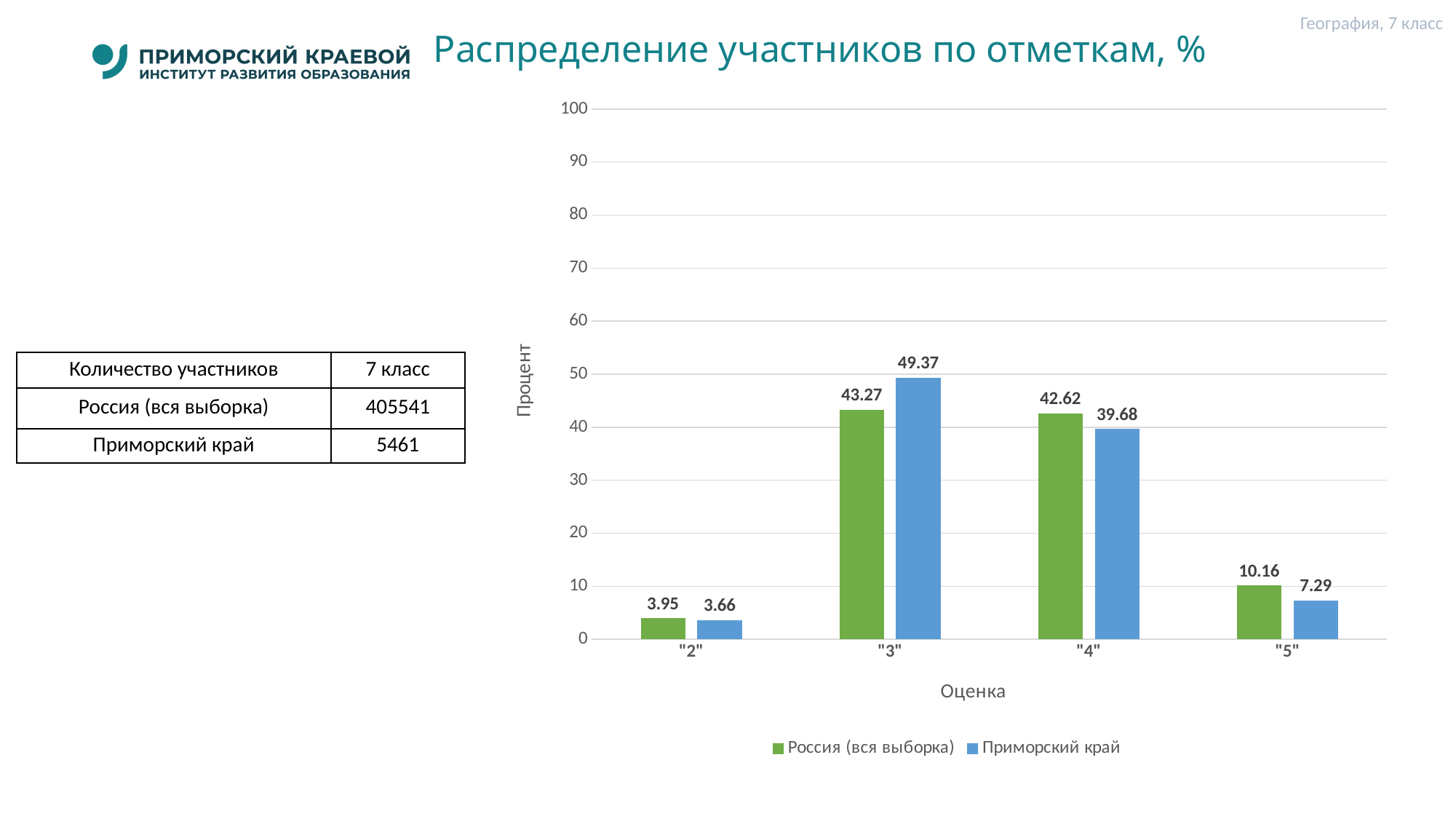
At grade "4", which series has the larger value: Россия (вся выборка) or Приморский край? Россия (вся выборка) What is the label of the y axis? Процент What is the difference between Приморский край and Россия (вся выборка) at grade "3"? 6.1 Is the value for Россия (вся выборка) at grade "5" greater or less than 20? less What is the value for Приморский край at grade "5"? 7.29 What kind of chart is shown on the slide? bar chart How many series does the legend list? 2 What is the value for Приморский край at grade "2"? 3.66 Which grade has the highest value for Приморский край? "3" What is the value for Россия (вся выборка) at grade "3"? 43.27 Which grade has the lowest value for Россия (вся выборка)? "2" How many grade categories are shown on the x axis? 4